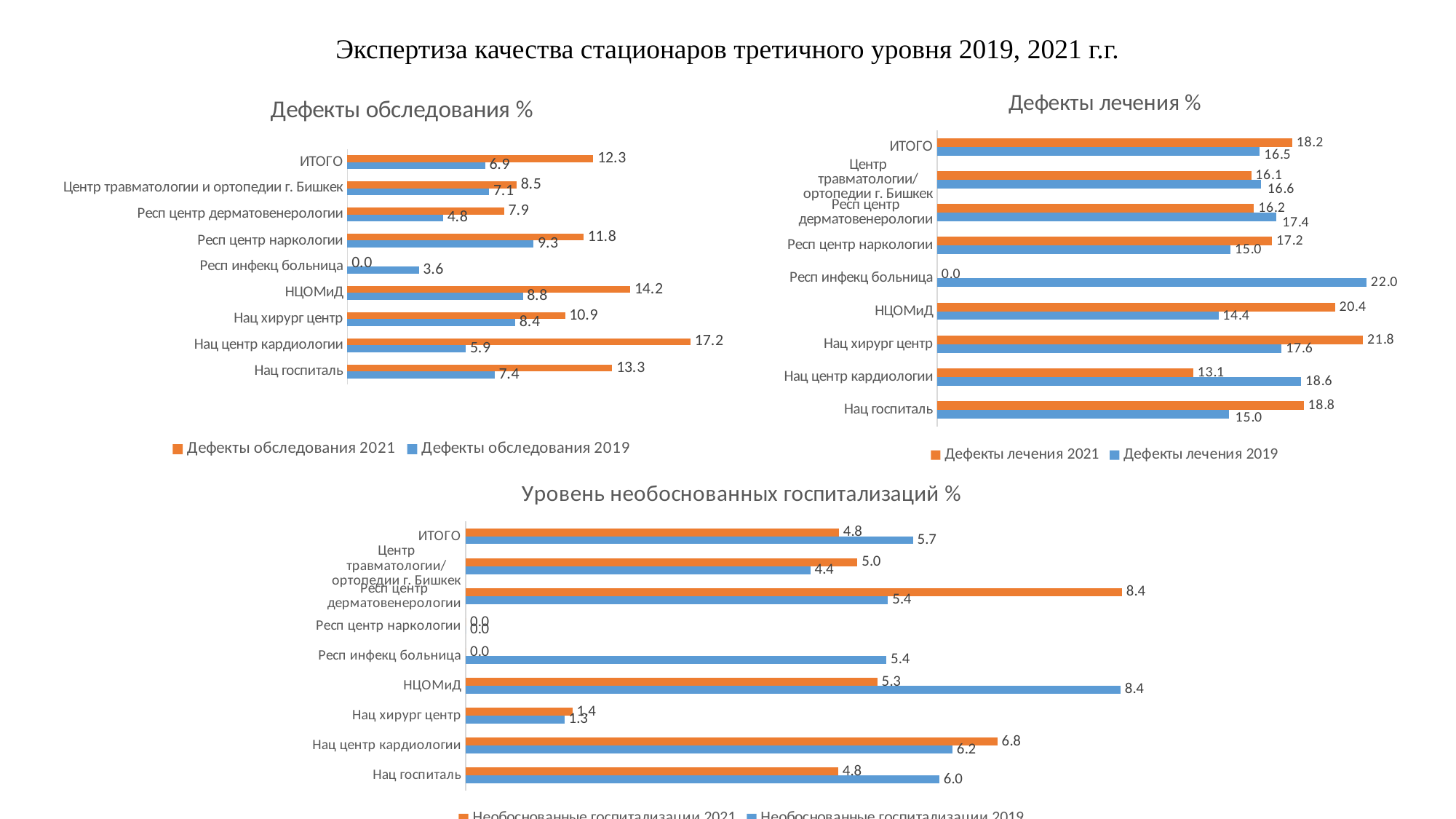
In the chart 'Дефекты обследования %', what is the difference between the 2021 and 2019 values for ИТОГО? 5.4 In the chart 'Уровень необоснованных госпитализаций %', what is the 2021 value for Респ центр дерматовенерологии? 8.4 In the chart 'Дефекты обследования %', which category has the highest 2021 value? Нац центр кардиологии In the chart 'Дефекты лечения %', how many series does the legend list? 2 In the chart 'Дефекты лечения %', which is larger for Нац центр кардиологии: the 2021 value or the 2019 value? 2019 In the chart 'Дефекты лечения %', which category has the highest 2021 value? Нац хирург центр In the chart 'Уровень необоснованных госпитализаций %', what is the difference between the 2019 and 2021 values for НЦОМиД? 3.1 In the chart 'Дефекты лечения %', what is the 2019 value for Респ инфекц больница? 22.0 In the chart 'Дефекты обследования %', how many categories are shown? 9 What is the title of the chart at the top right of the slide? Дефекты лечения % What kind of chart is 'Уровень необоснованных госпитализаций %'? bar chart In the chart 'Дефекты обследования %', what is the value for Нац центр кардиологии in 2021? 17.2